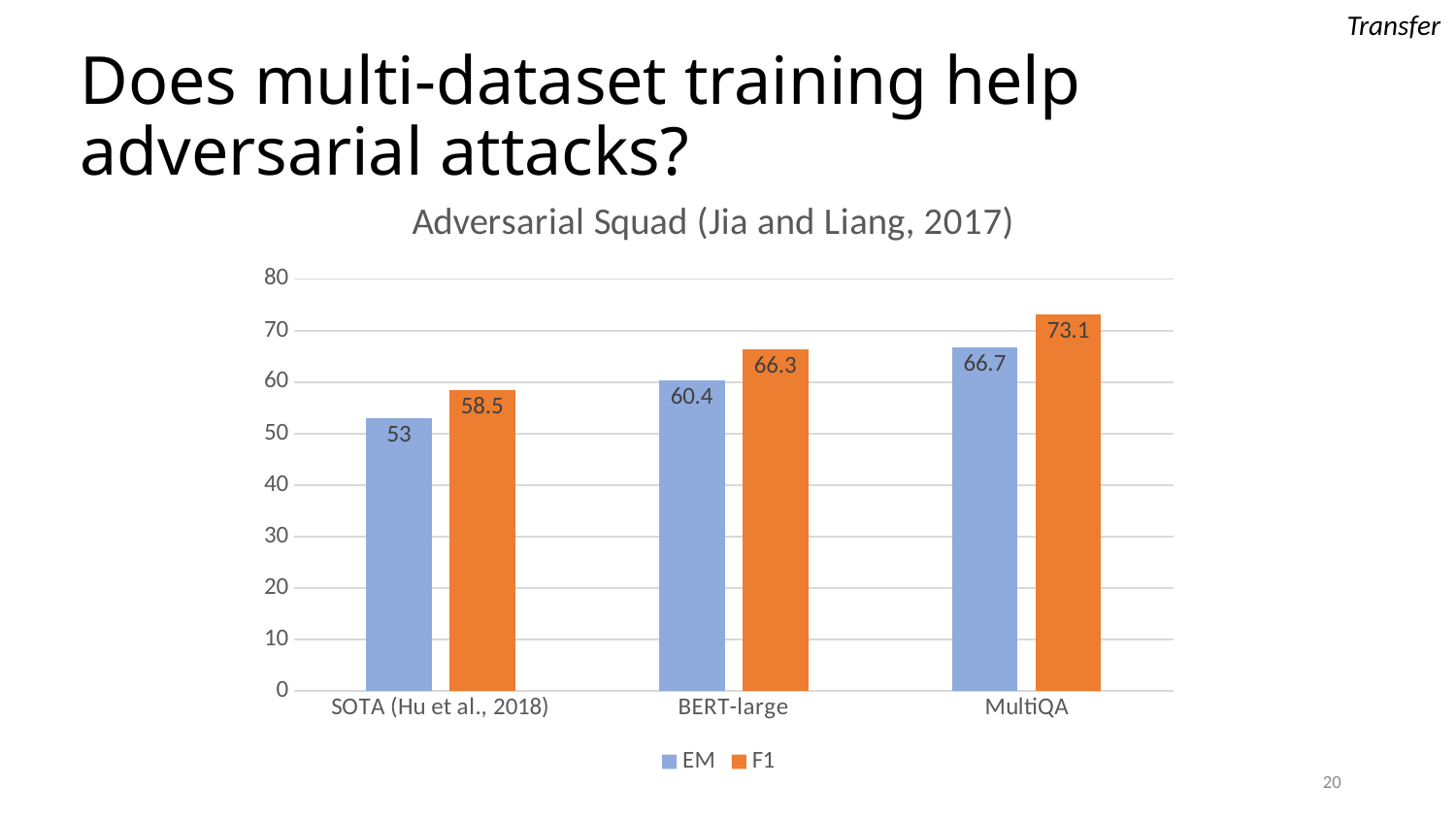
What is the title of the chart? Adversarial Squad (Jia and Liang, 2017) What is the difference in F1 between MultiQA and BERT-large? 6.8 How many models are shown on the x axis? 3 Which is larger, the EM value for BERT-large or the EM value for MultiQA? MultiQA What is the EM value for MultiQA? 66.7 What is the difference between the F1 and EM values for SOTA (Hu et al., 2018)? 5.5 What is the F1 value for BERT-large? 66.3 What is the EM value for SOTA (Hu et al., 2018)? 53 What is the F1 value for MultiQA? 73.1 Which model has the highest F1 value? MultiQA How many series does the legend list? 2 Which model has the lowest EM value? SOTA (Hu et al., 2018)